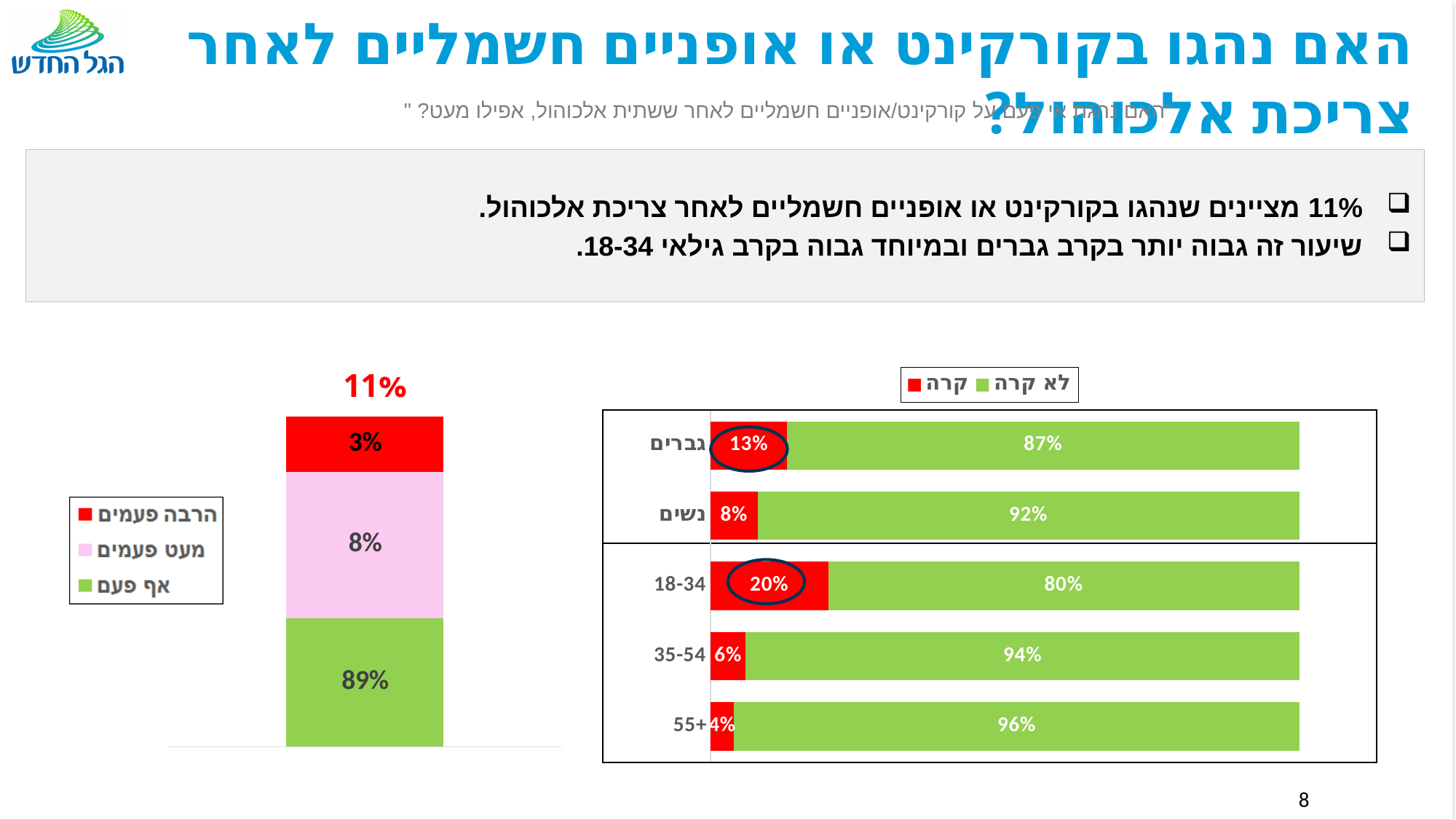
In the left-hand chart, what is the combined total of the הרבה פעמים and מעט פעמים segments? 11% In the left-hand chart, what is the value of the מעט פעמים segment? 8% In the left-hand chart, which colour represents אף פעם? Green In the right-hand chart, which category has the highest value for קרה? 18-34 In the right-hand chart, what is the value of קרה for the 18-34 age group? 20% In the right-hand chart, which has a larger קרה value, 35-54 or 55+? 35-54 In the right-hand chart, what is the difference between the קרה values for גברים and נשים? 5% How many series does the legend of the right-hand chart list? 2 In the right-hand chart, which category has the lowest value for קרה? 55+ What kind of chart is the right-hand chart? Stacked bar chart In the right-hand chart, what is the value of לא קרה for נשים? 92% How many categories are shown in the right-hand chart? 5